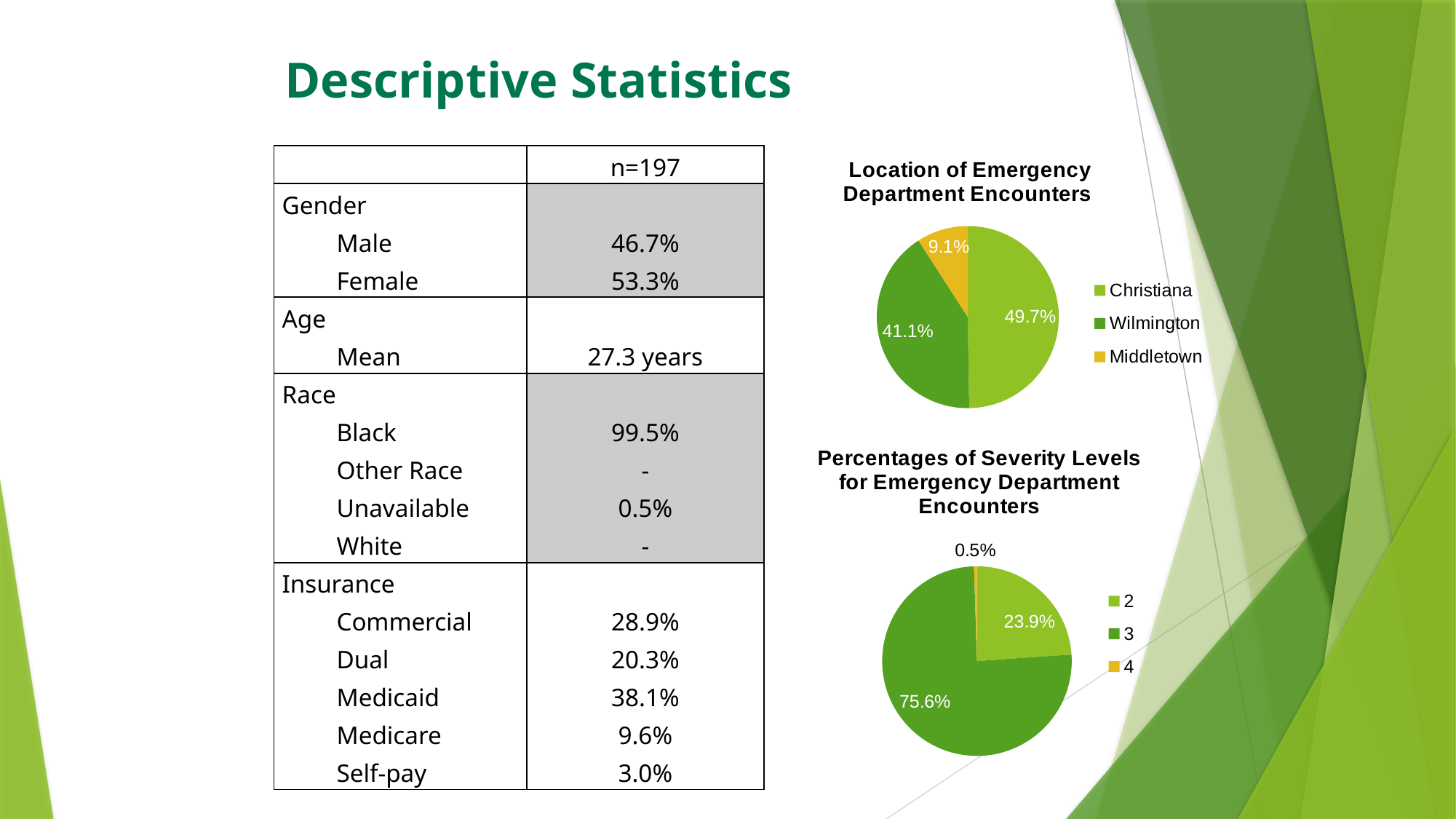
In the 'Percentages of Severity Levels for Emergency Department Encounters' chart, which severity levels does the legend list? 2, 3, 4 In the 'Location of Emergency Department Encounters' chart, which location has the smallest share? Middletown How many locations are shown in the 'Location of Emergency Department Encounters' chart? 3 In the 'Percentages of Severity Levels for Emergency Department Encounters' chart, what share is severity level 3? 75.6% In the 'Location of Emergency Department Encounters' chart, which location has the largest share? Christiana What kind of chart is the 'Location of Emergency Department Encounters' chart? Pie chart In the 'Location of Emergency Department Encounters' chart, what share of encounters were at Christiana? 49.7% In the 'Location of Emergency Department Encounters' chart, what share of encounters were at Wilmington? 41.1% In the 'Percentages of Severity Levels for Emergency Department Encounters' chart, what share is severity level 4? 0.5% In the 'Location of Emergency Department Encounters' chart, what is the difference between the Christiana and Wilmington shares? 8.6% In the 'Percentages of Severity Levels for Emergency Department Encounters' chart, what is the difference between the shares for severity levels 3 and 2? 51.7% In the 'Percentages of Severity Levels for Emergency Department Encounters' chart, which severity level has the largest share? 3